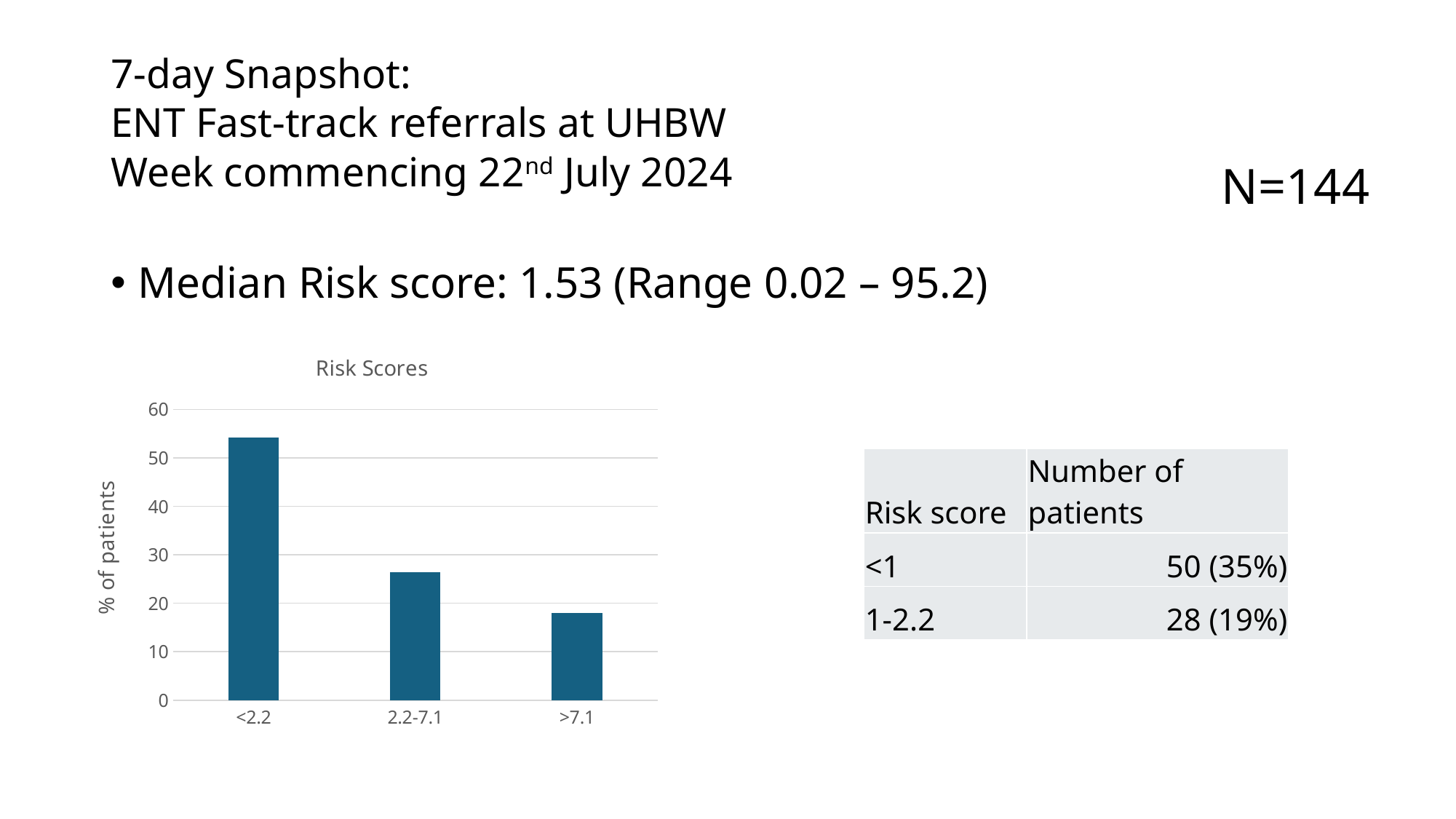
How many risk score categories are shown on the x axis of the Risk Scores chart? 3 Which risk score category has the lowest percentage of patients? >7.1 Which has a higher percentage of patients, the 2.2-7.1 category or the >7.1 category? 2.2-7.1 What kind of chart is shown on the slide? bar chart Is the value for the 2.2-7.1 category greater or less than 30? less What is the label on the y axis of the chart? % of patients Do the bar values rise or fall from left to right across the x axis? fall What is the title of the chart? Risk Scores Is the value for the >7.1 category greater or less than 10? greater Is the value for the >7.1 category greater or less than 20? less Which risk score category has the highest percentage of patients? <2.2